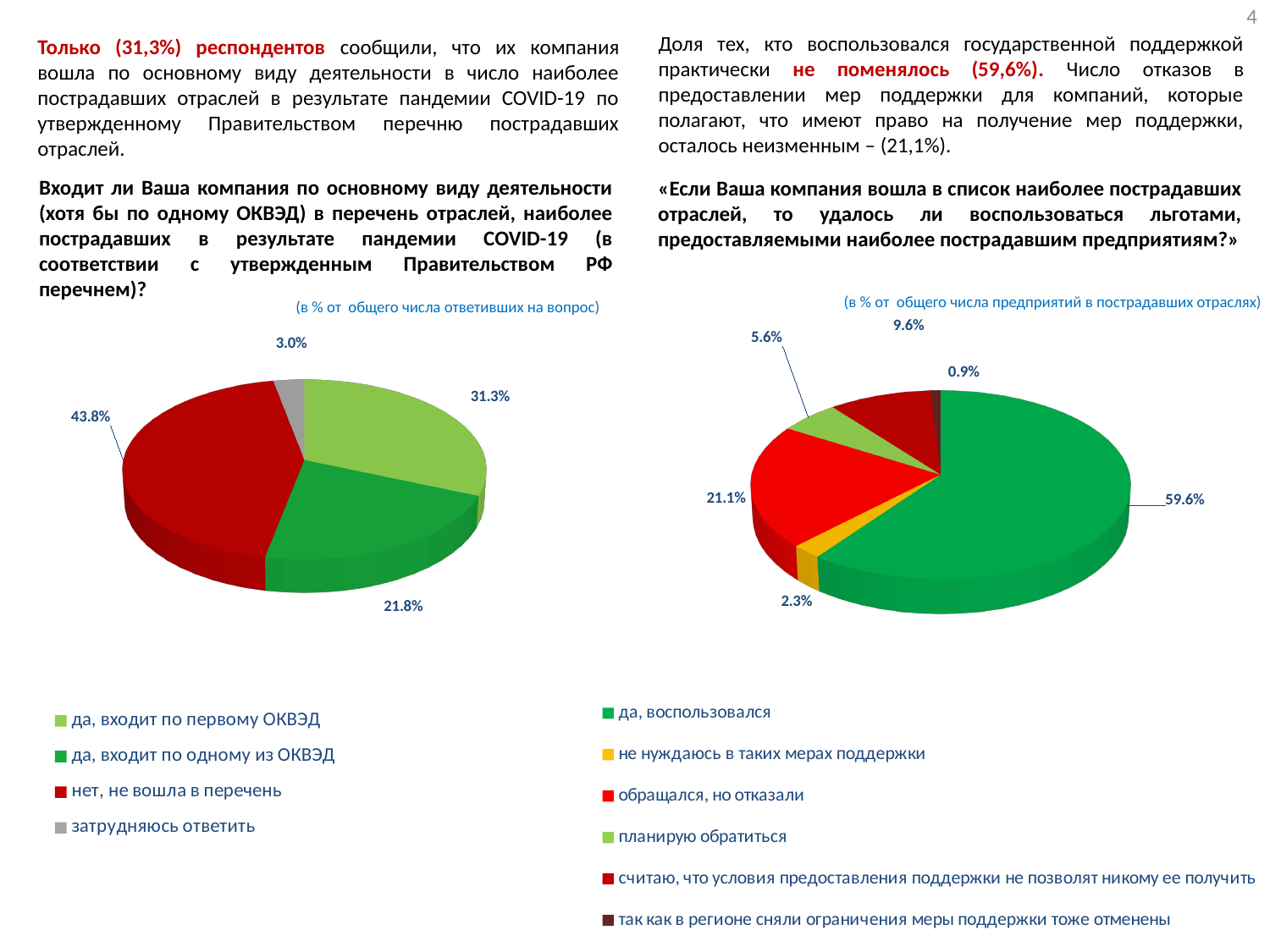
How many categories does the legend of the left pie chart list? 4 On the left pie chart, which category has the largest share? нет, не вошла в перечень On the right pie chart, what share of enterprises answered "да, воспользовался"? 59.6% On the right pie chart, what share of enterprises answered "обращался, но отказали"? 21.1% What type of chart is shown on the right side of the slide? Pie chart On the left pie chart, which category has the smallest share? затрудняюсь ответить On the right pie chart, which category has the smallest share? так как в регионе сняли ограничения меры поддержки тоже отменены How many categories does the legend of the right pie chart list? 6 On the left pie chart, what is the difference between the shares for "нет, не вошла в перечень" and "да, входит по одному из ОКВЭД"? 22.0% On the left pie chart, what share of respondents answered "да, входит по первому ОКВЭД"? 31.3% On the left pie chart, what share of respondents answered "нет, не вошла в перечень"? 43.8% On the right pie chart, which is larger: the share for "планирую обратиться" or the share for "не нуждаюсь в таких мерах поддержки"? планирую обратиться